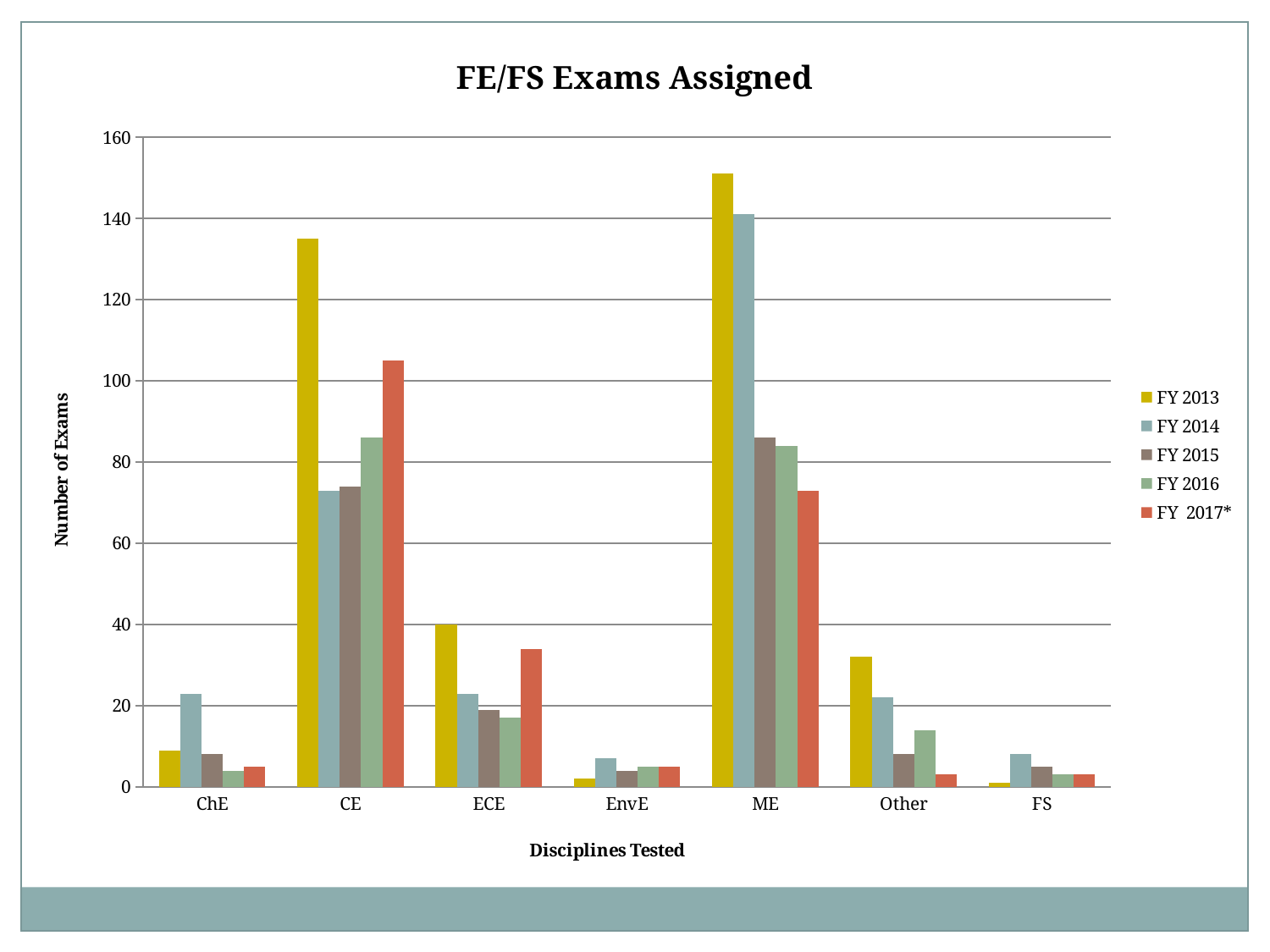
What is the title of the chart? FE/FS Exams Assigned Is the FY 2017* value for CE greater or less than 100? greater What is the title of the y axis? Number of Exams How many series does the legend list? 5 How many disciplines are shown along the x axis? 7 What kind of chart is shown on the slide? bar chart Is the FY 2013 value for CE greater or less than 120? greater Within the ME group, which fiscal year has the lowest bar? FY 2017* Which is larger: the FY 2017* value for CE or the FY 2017* value for ME? CE For ME, do the bars rise or fall from FY 2013 to FY 2017*? fall Is the FY 2016 value for CE greater or less than 80? greater Which discipline has the highest FY 2013 bar? ME